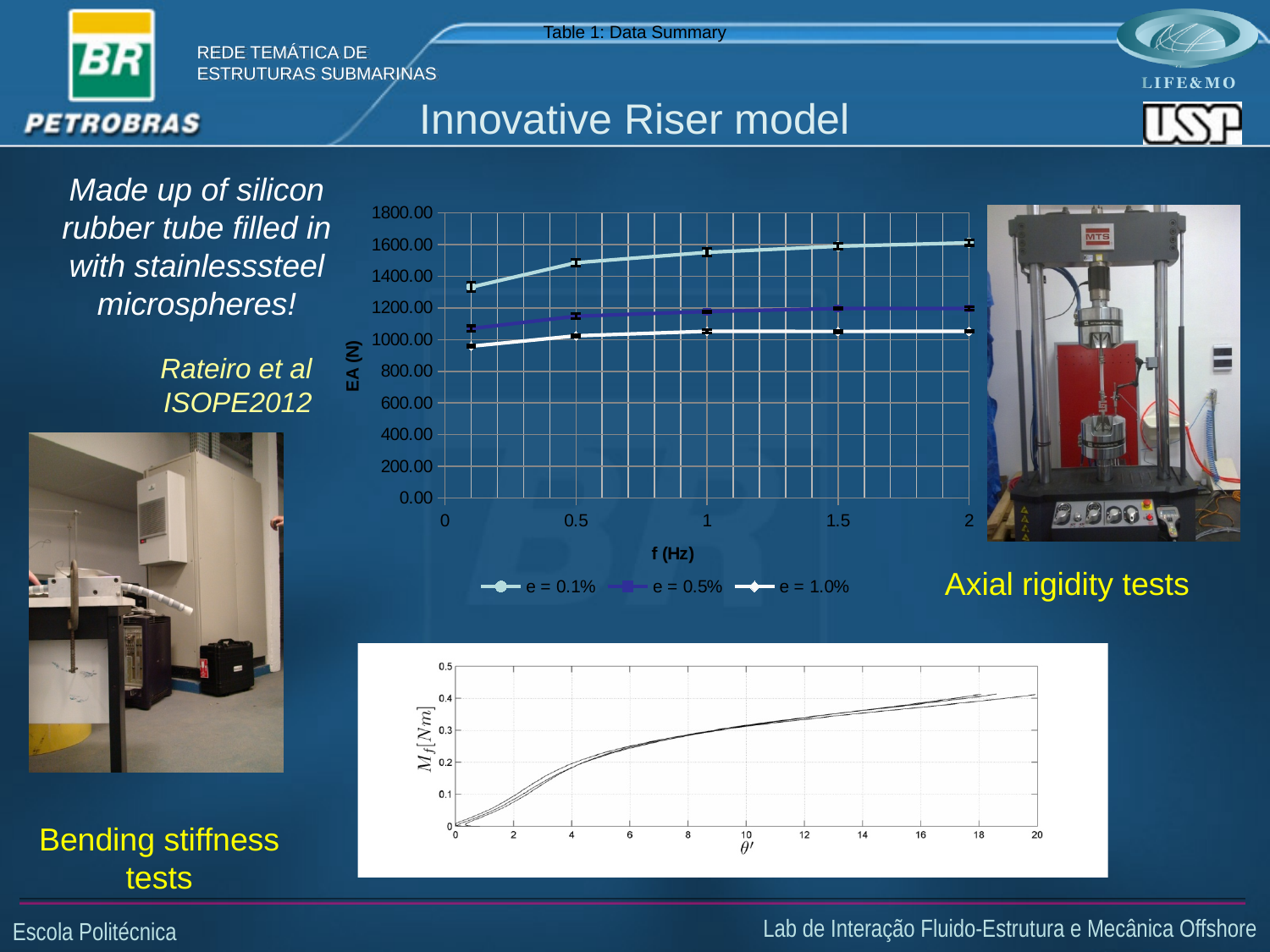
In the top chart (EA vs f), which series has the lowest EA values across all frequencies? e = 1.0% In the bottom chart (Mf vs θ'), is the value of Mf at θ' = 10 greater or less than 0.4? less In the bottom chart (Mf vs θ'), does Mf rise or fall as θ' increases? rise In the top chart (EA vs f), is the EA value for e = 0.1% at f = 2 Hz greater or less than 1400? greater In the top chart (EA vs f), does the e = 0.1% series rise or fall as f increases? rise In the top chart (EA vs f), what are the legend entries? e = 0.1%, e = 0.5%, e = 1.0% In the top chart (EA vs f), how many data points does the e = 0.1% series have? 5 In the top chart (EA vs f), how many series does the legend list? 3 In the top chart (EA vs f), is the EA value for e = 1.0% at f = 0.5 Hz greater or less than 1200? less What kind of chart is the top chart with EA (N) on the vertical axis? line chart In the top chart (EA vs f), which series has the highest EA values across all frequencies? e = 0.1%